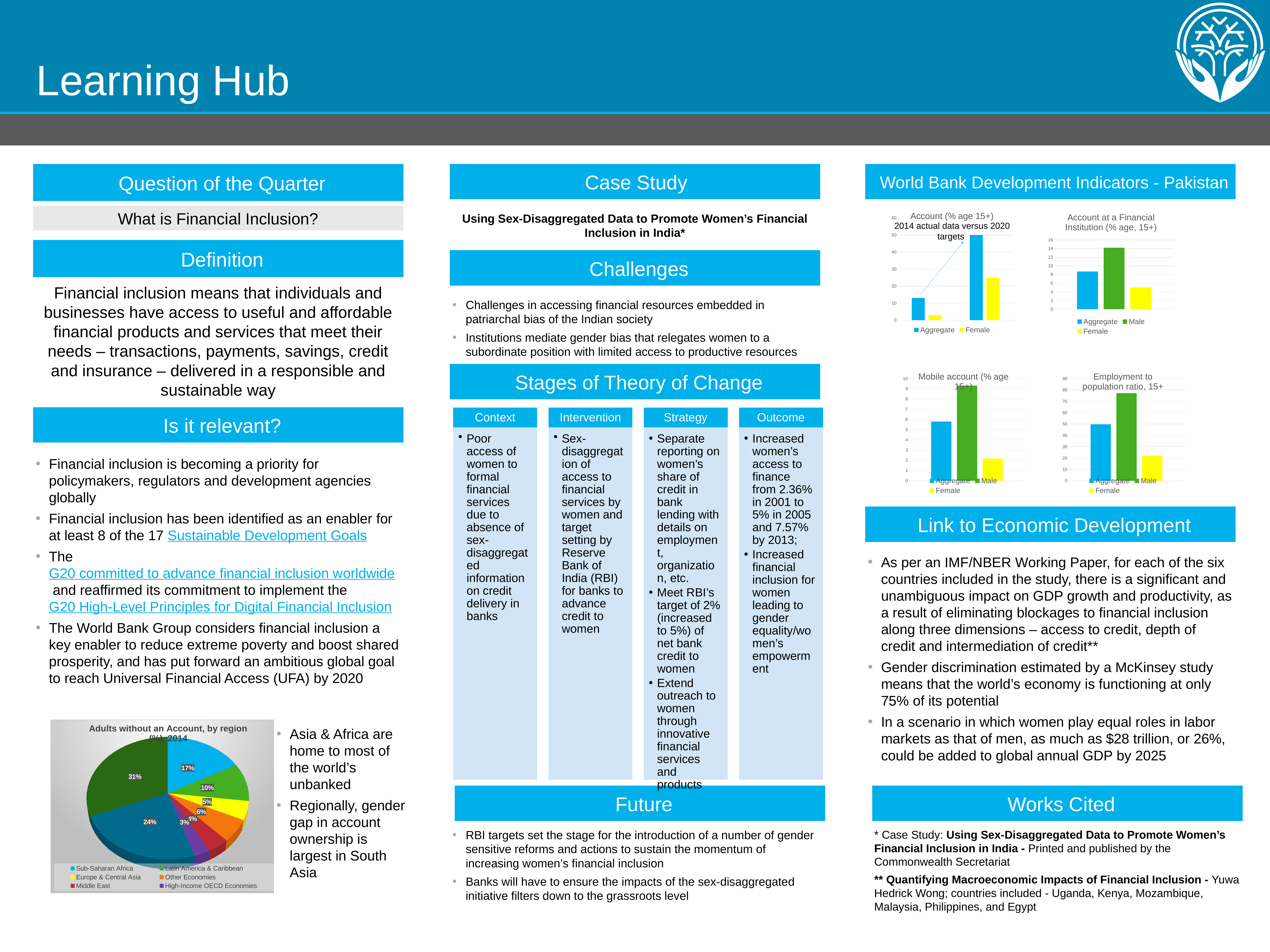
What kind of chart is 'Adults without an Account, by region (%), 2014'? pie chart In the chart 'Account at a Financial Institution (% age, 15+)', how many series does the legend list? 3 In the chart 'Account at a Financial Institution (% age, 15+)', is the value for Female greater or less than 8? less In the chart 'Mobile account (% age 15+)', which is larger, the value for Male or the value for Female? Male In the chart 'Account (% age 15+) 2014 actual data versus 2020 targets', how many series does the legend list? 2 How many slices does the pie chart 'Adults without an Account, by region (%), 2014' have? 8 In the chart 'Employment to population ratio, 15+', which series has the highest value? Male In the chart 'Employment to population ratio, 15+', which series has the lowest value? Female In the chart 'Account at a Financial Institution (% age, 15+)', is the value for Male greater or less than 10? greater In the pie chart 'Adults without an Account, by region (%), 2014', what is the value for Latin America & Caribbean? 10% In the pie chart 'Adults without an Account, by region (%), 2014', what is the percentage of the largest slice? 31% In the pie chart 'Adults without an Account, by region (%), 2014', what is the value for Sub-Saharan Africa? 17%